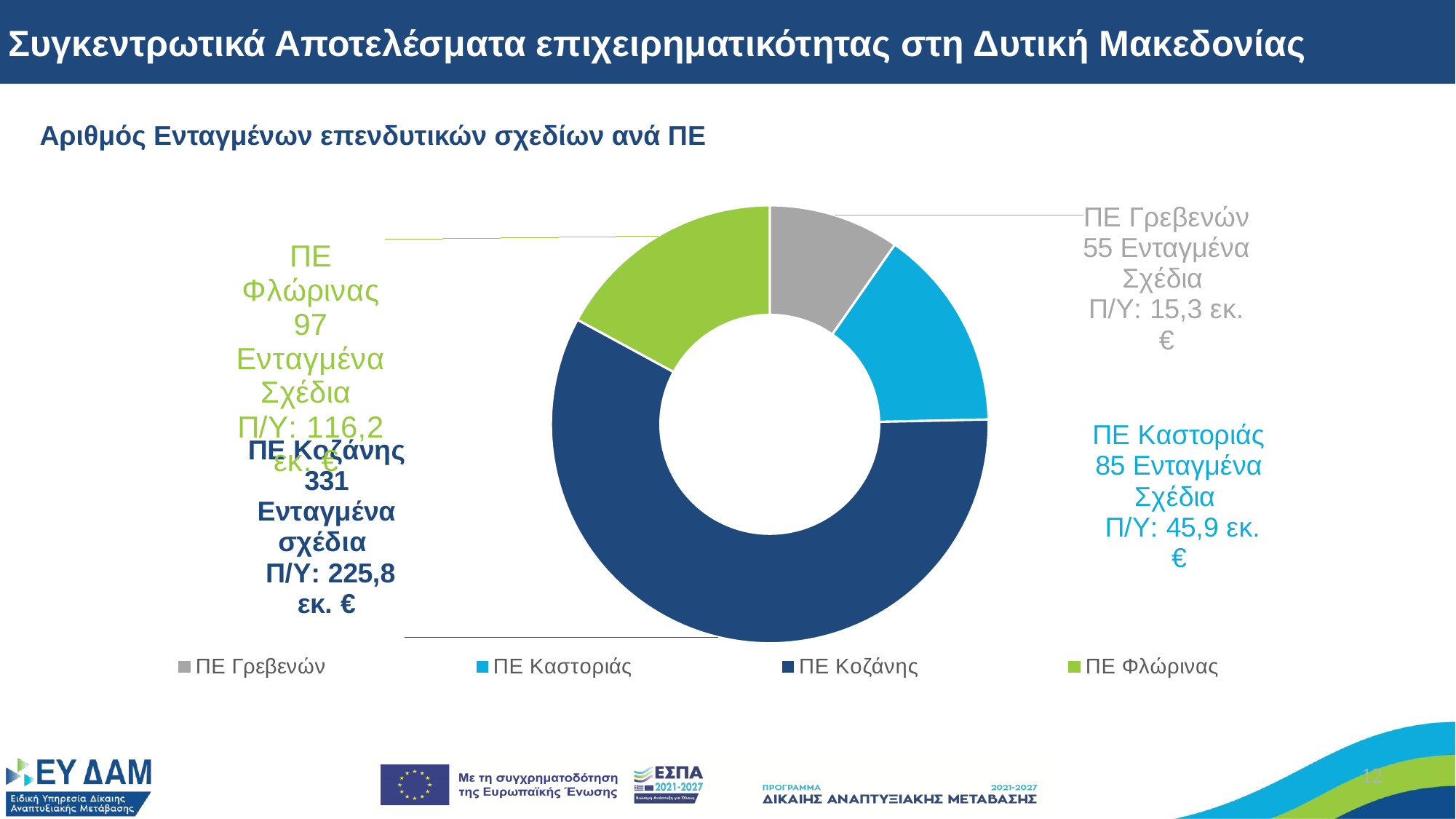
What type of chart is shown on the slide? Doughnut (pie) chart What is the budget (Π/Υ) shown for ΠΕ Καστοριάς? 45,9 εκ. € What is the budget (Π/Υ) shown for ΠΕ Φλώρινας? 116,2 εκ. € Which has more approved investment plans, ΠΕ Καστοριάς or ΠΕ Γρεβενών? ΠΕ Καστοριάς What is the total number of approved investment plans across all four regional units? 568 Which regional unit has the highest number of approved investment plans? ΠΕ Κοζάνης How many approved investment plans (Ενταγμένα Σχέδια) does ΠΕ Κοζάνης have? 331 How many regional units (ΠΕ) are shown in the chart? 4 What is the difference in the number of approved investment plans between ΠΕ Φλώρινας and ΠΕ Καστοριάς? 12 What colour represents ΠΕ Φλώρινας in the chart? Green Which regional unit has the lowest number of approved investment plans? ΠΕ Γρεβενών How many approved investment plans does ΠΕ Γρεβενών have? 55